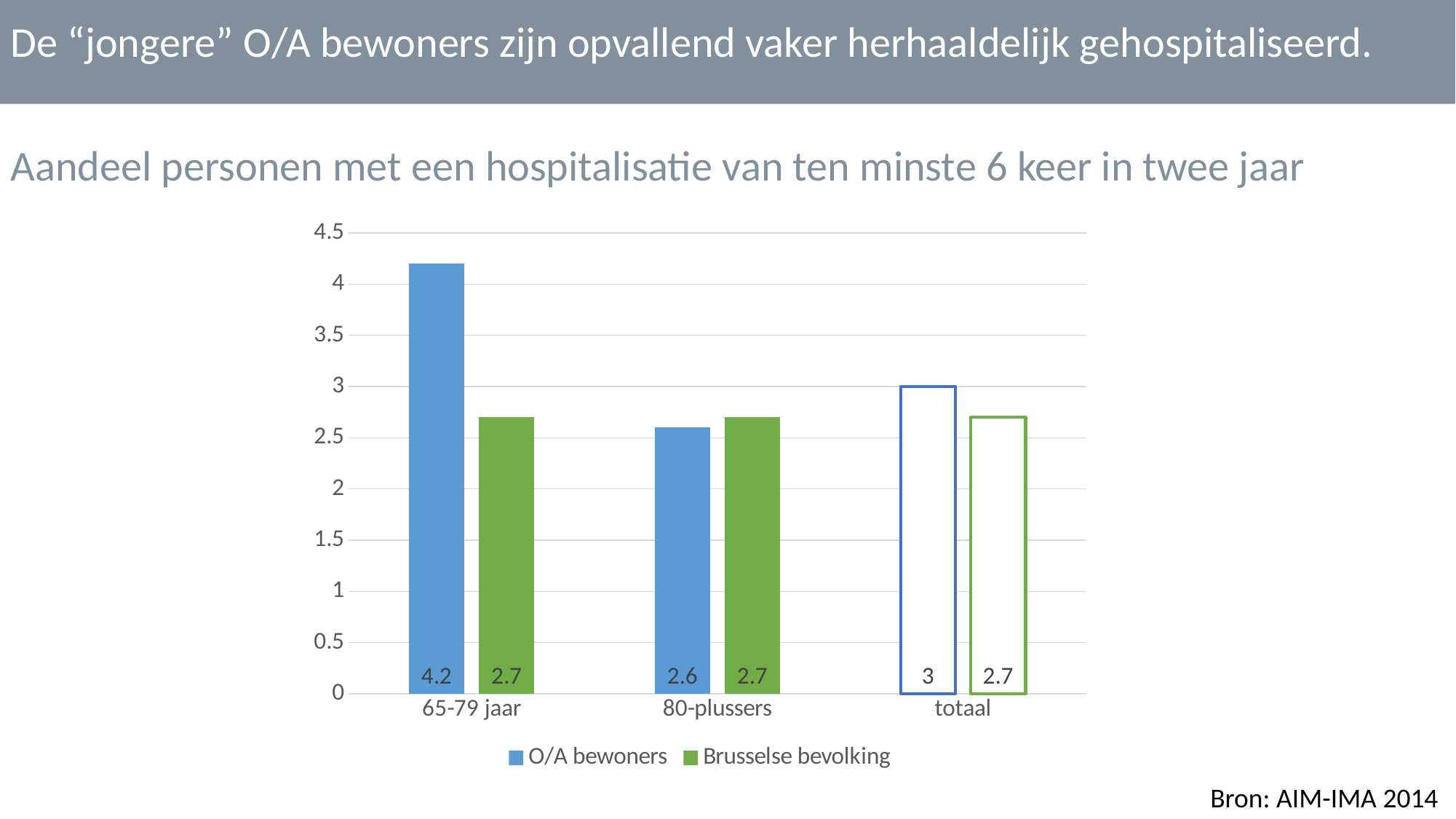
What is the source cited at the bottom of the slide? AIM-IMA 2014 What is the value for O/A bewoners in the 65-79 jaar category? 4.2 Which category has the highest value for O/A bewoners? 65-79 jaar Which category has the lowest value for O/A bewoners? 80-plussers How many series does the legend list? 2 How many categories are shown on the x axis? 3 What kind of chart is shown on the slide? bar chart Is the value for O/A bewoners in the 65-79 jaar category greater or less than 4? greater Which is larger in the 80-plussers category: O/A bewoners or Brusselse bevolking? Brusselse bevolking What is the value for Brusselse bevolking in the 80-plussers category? 2.7 What is the value for O/A bewoners in the totaal category? 3 What is the difference between O/A bewoners and Brusselse bevolking in the 65-79 jaar category? 1.5